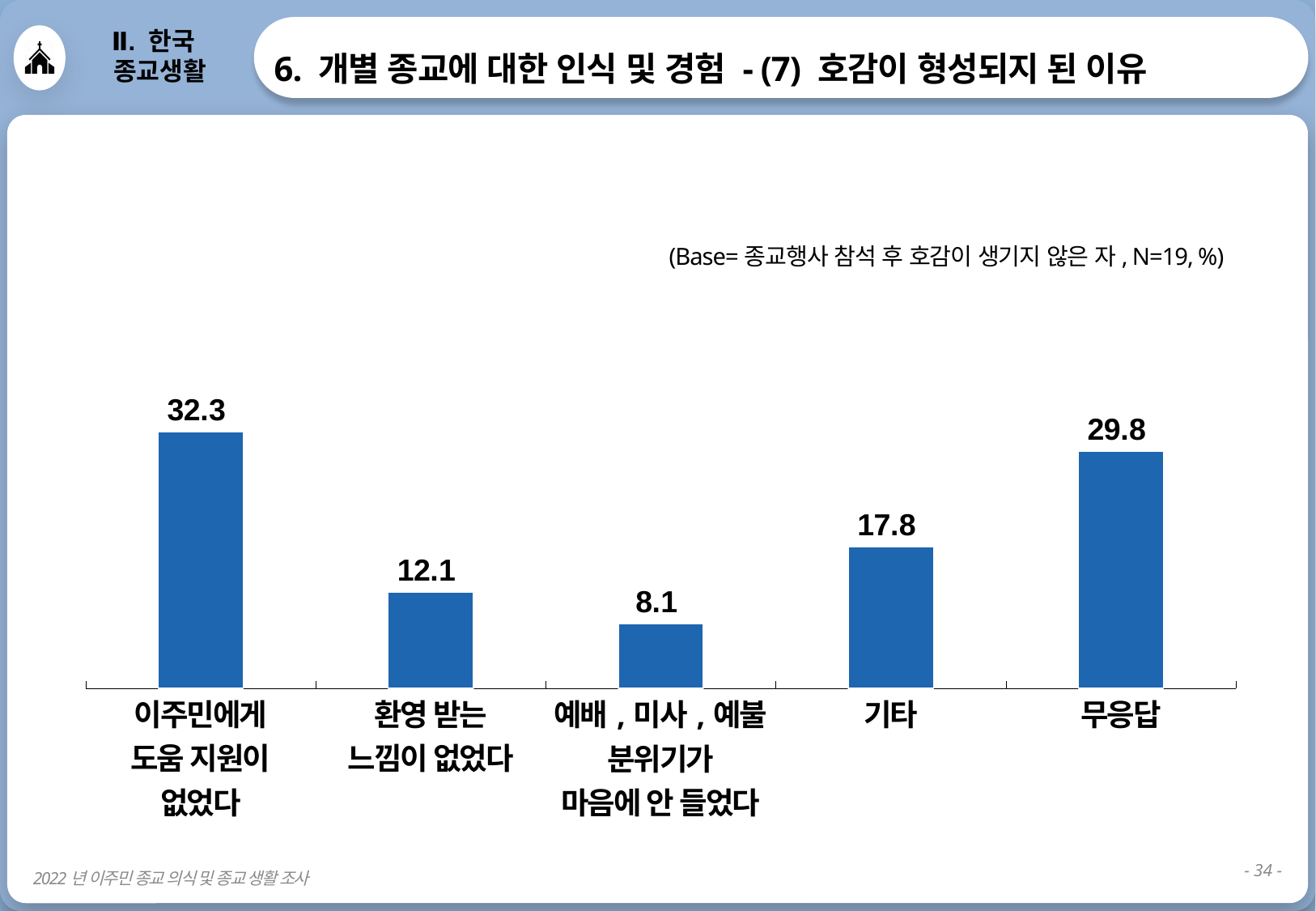
What is the difference between the values for 이주민에게 도움 지원이 없었다 and 무응답? 2.5 Which category has the highest value? 이주민에게 도움 지원이 없었다 What kind of chart is shown on the slide? bar chart What is the value for 환영 받는 느낌이 없었다? 12.1 What is the sample size (N) stated in the base note above the chart? 19 Which is larger, the value for 기타 or the value for 환영 받는 느낌이 없었다? 기타 How many categories are shown in the chart? 5 What is the value for 기타? 17.8 What is the value for 예배, 미사, 예불 분위기가 마음에 안 들었다? 8.1 Which category has the lowest value? 예배, 미사, 예불 분위기가 마음에 안 들었다 What is the value for 이주민에게 도움 지원이 없었다? 32.3 What is the value for 무응답? 29.8